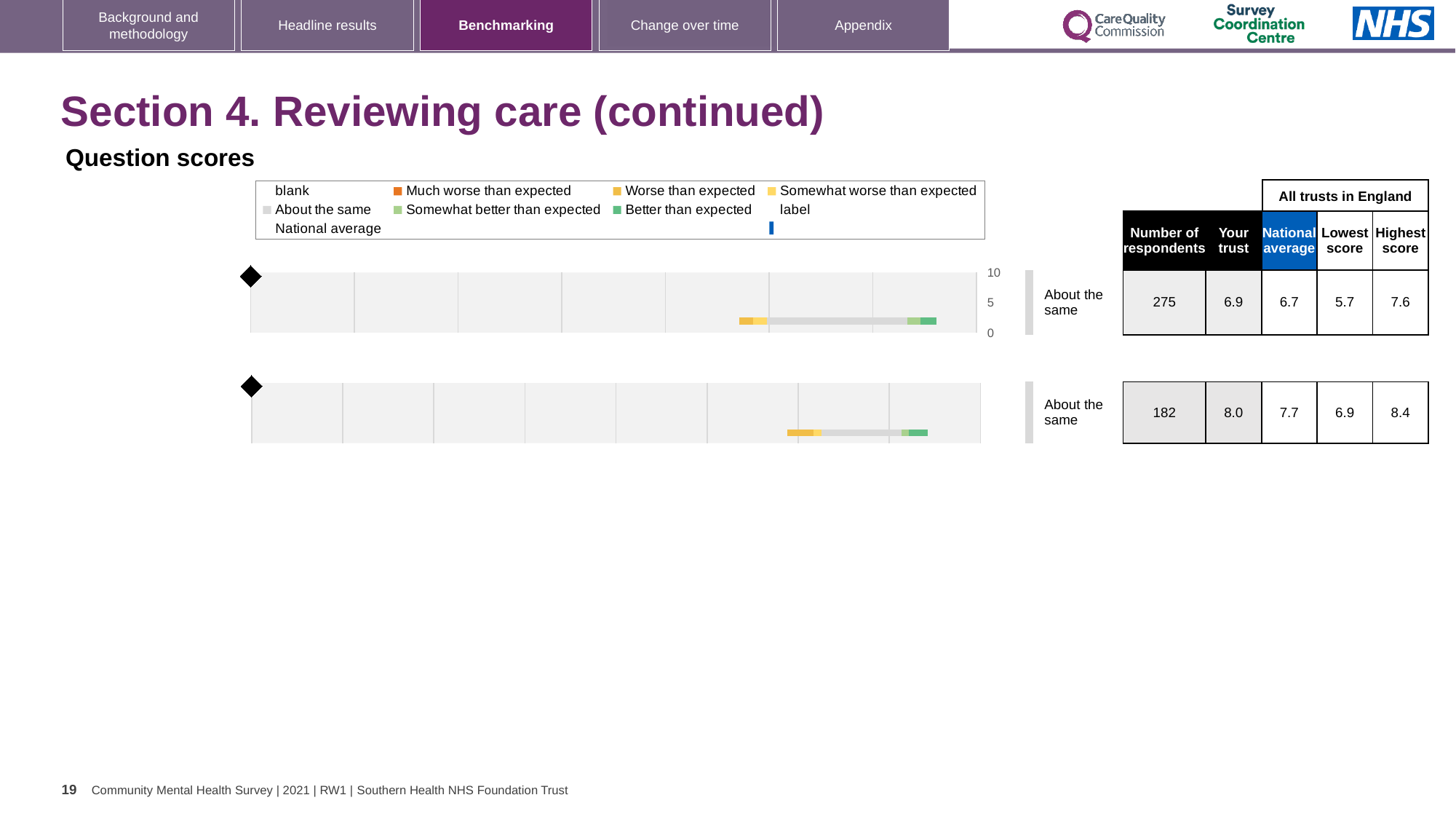
For the bottom chart, what is the 'Your trust' score shown in the table? 8.0 What benchmark category label is shown next to the top chart? About the same For the bottom chart, what is the highest score among all trusts in England? 8.4 For the top chart, what is the national average shown in the table? 6.7 What kind of chart is the top chart on the slide? bar chart How many benchmarking charts are shown on the slide? 2 For the top chart, how many respondents are listed? 275 For the bottom chart, what is the lowest score among all trusts in England? 6.9 For the top chart, what is the difference between the 'Your trust' score and the national average? 0.2 Which chart has the larger 'Your trust' score, the top chart or the bottom chart? bottom chart For the bottom chart, what is the difference between the highest and lowest scores among all trusts in England? 1.5 For the top chart, what is the 'Your trust' score shown in the table? 6.9